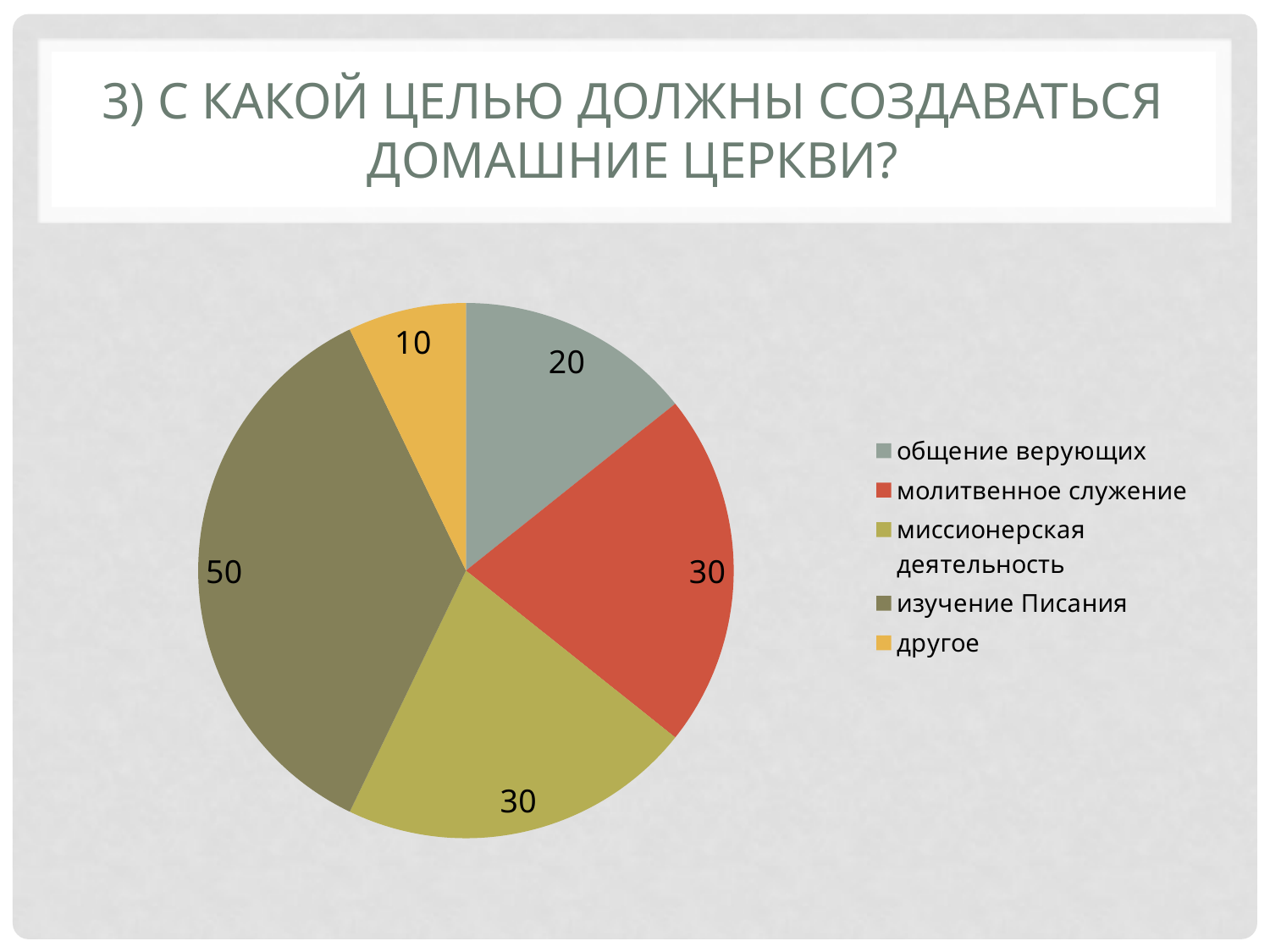
What is the total of all the slice values in the pie chart? 140 What type of chart is shown on the slide? pie chart Which is larger, the value for миссионерская деятельность or the value for другое? миссионерская деятельность What is the value for изучение Писания? 50 What is the value for молитвенное служение? 30 What is the difference between the values for изучение Писания and общение верующих? 30 What colour is the slice for другое? yellow How many categories does the pie chart have? 5 What is the value for общение верующих? 20 Which category has the smallest slice of the pie? другое Which category has the largest slice of the pie? изучение Писания What is the value for другое? 10